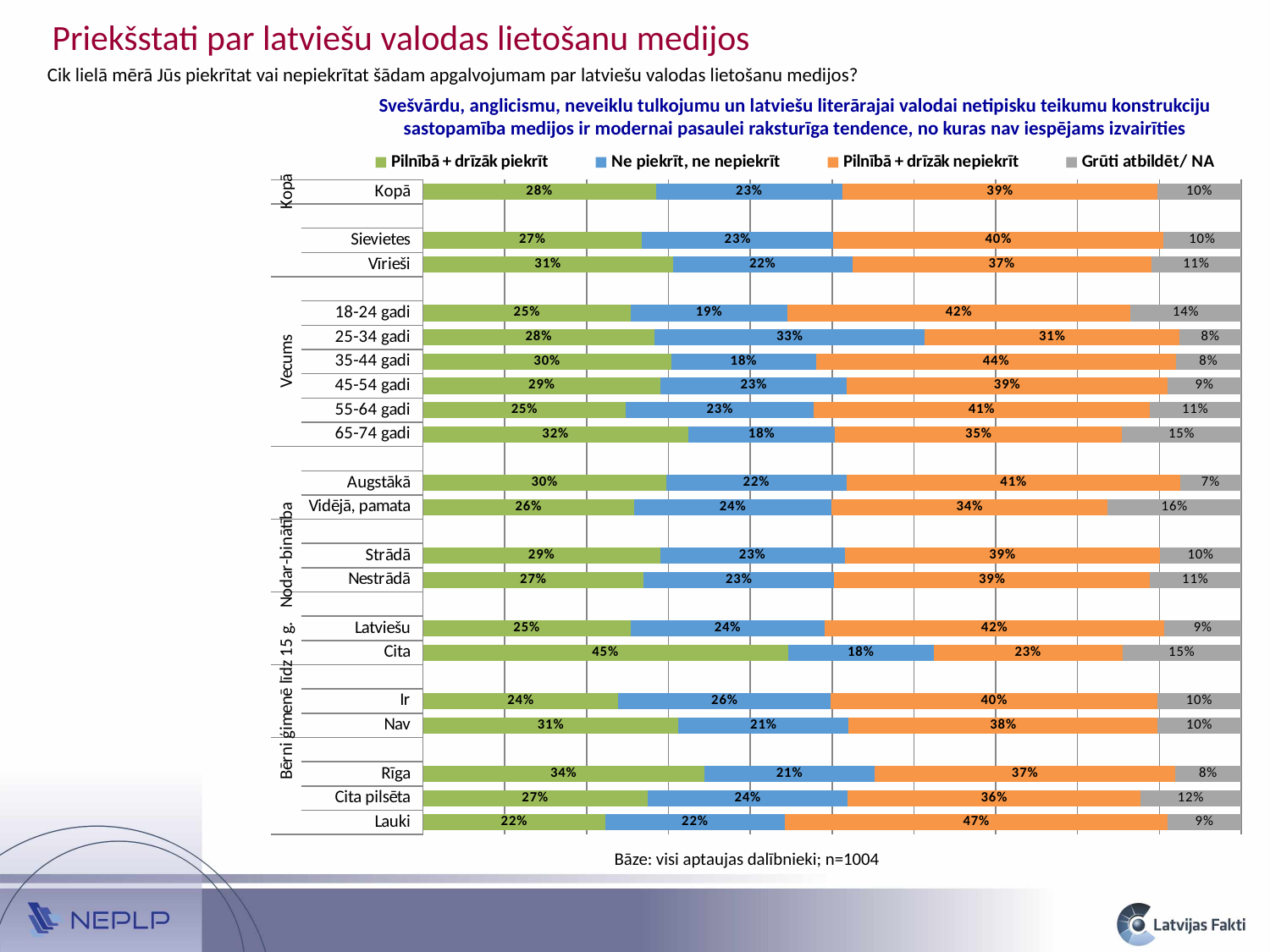
Which category has the lowest value for "Pilnībā + drīzāk piekrīt"? Lauki Which is larger: the "Ne piekrīt, ne nepiekrīt" value for 25-34 gadi or for 35-44 gadi? 25-34 gadi What is the difference between the "Pilnībā + drīzāk nepiekrīt" values for Lauki and Rīga? 10% How many categories are plotted in the chart? 20 What kind of chart is shown on the slide? Stacked bar chart What is the value of "Pilnībā + drīzāk nepiekrīt" for Lauki? 47% What colour represents the "Grūti atbildēt/ NA" series? Grey What is the total of the "Pilnībā + drīzāk piekrīt" and "Ne piekrīt, ne nepiekrīt" values for Cita? 63% Which category has the highest value for "Pilnībā + drīzāk piekrīt"? Cita What is the value of "Grūti atbildēt/ NA" for Vidējā, pamata? 16% How many series does the legend list? 4 What is the value of "Pilnībā + drīzāk piekrīt" for Kopā? 28%